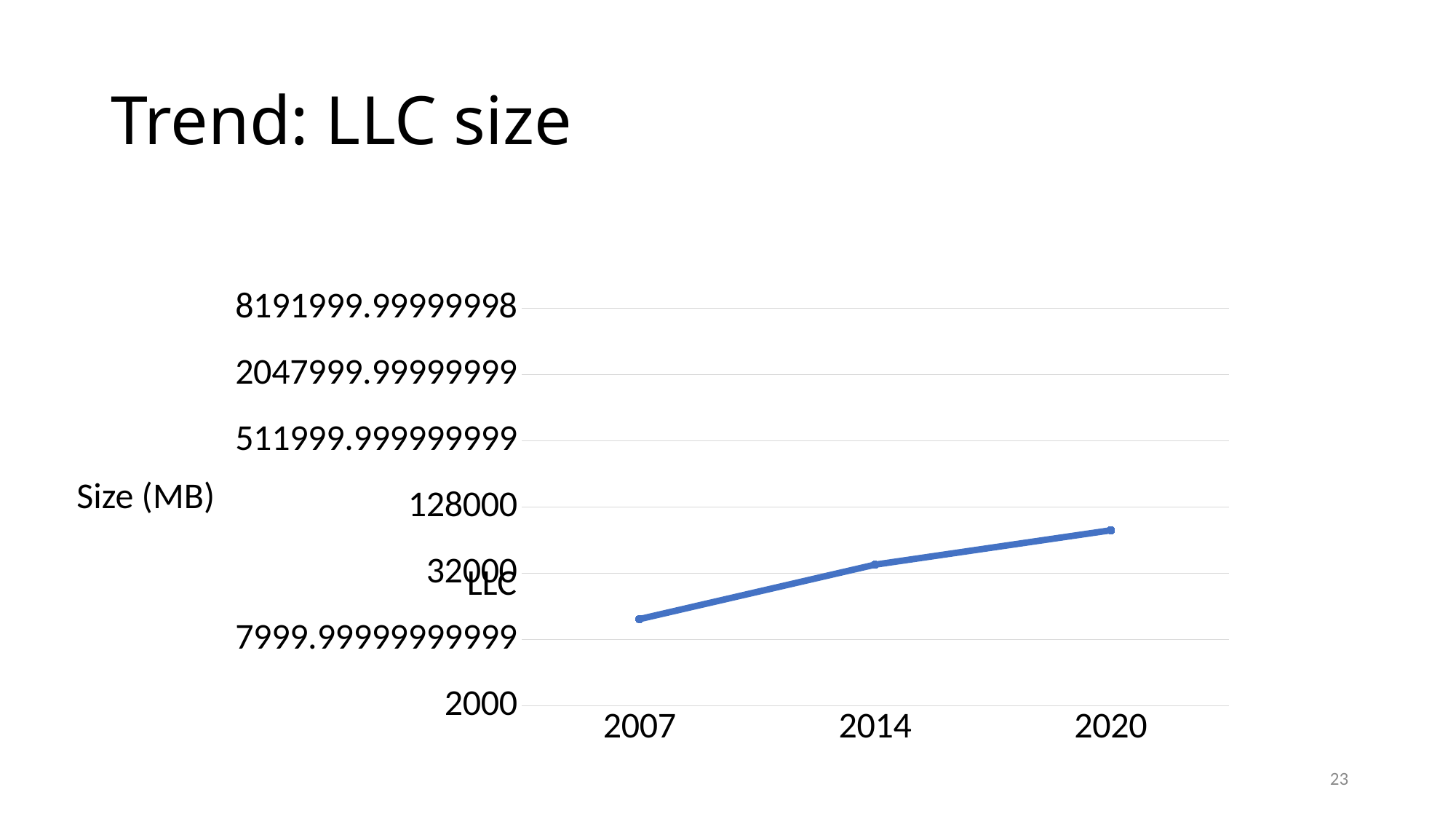
What kind of chart is shown on the slide? line chart Which year has the highest LLC size? 2020 Is the LLC size for 2020 greater or less than 32000? greater Which year has the lowest LLC size? 2007 Is the LLC size for 2007 greater or less than 32000? less Which is larger, the LLC size in 2007 or in 2020? 2020 Do the LLC size values rise or fall from 2007 to 2020? rise What is the label on the y axis? Size (MB) How many data points are plotted on the line? 3 What is the title of the slide? Trend: LLC size Is the LLC size for 2020 greater or less than 128000? less